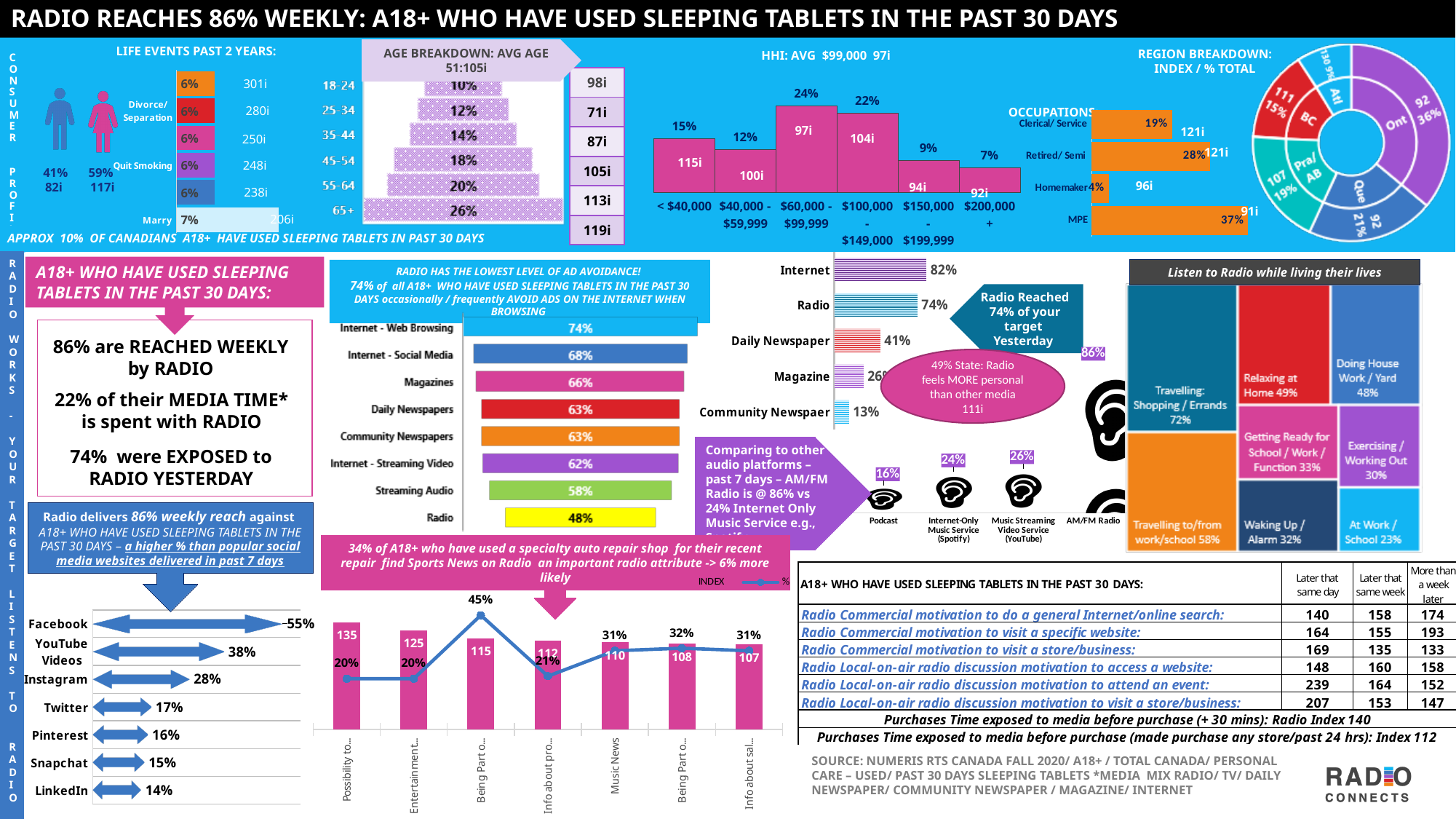
In the ad avoidance bar chart, which medium has the highest level of ad avoidance? Internet - Web Browsing In the Occupations chart, what percentage is shown for Retired/ Semi? 28% In the HHI chart, which income group has the lowest percentage? $200,000 + In the audio platforms past 7 days chart, what is the value for Podcast? 16% How many social media websites are listed in the social media past 7 days chart? 7 In the media reached yesterday chart, which is larger, Internet or Radio? Internet In the media reached yesterday chart (Internet, Radio, Daily Newspaper, Magazine, Community Newspaper), what is the value for Daily Newspaper? 41% In the social media past 7 days chart, what percentage is shown for Instagram? 28% In the age breakdown chart, what percentage is shown for the 65+ age group? 26% In the ad avoidance bar chart, what is the difference between Internet - Social Media and Streaming Audio? 10% In the ad avoidance bar chart, what is the value for Radio? 48% In the HHI chart, what percentage is shown for the $60,000 - $99,999 income group? 24%